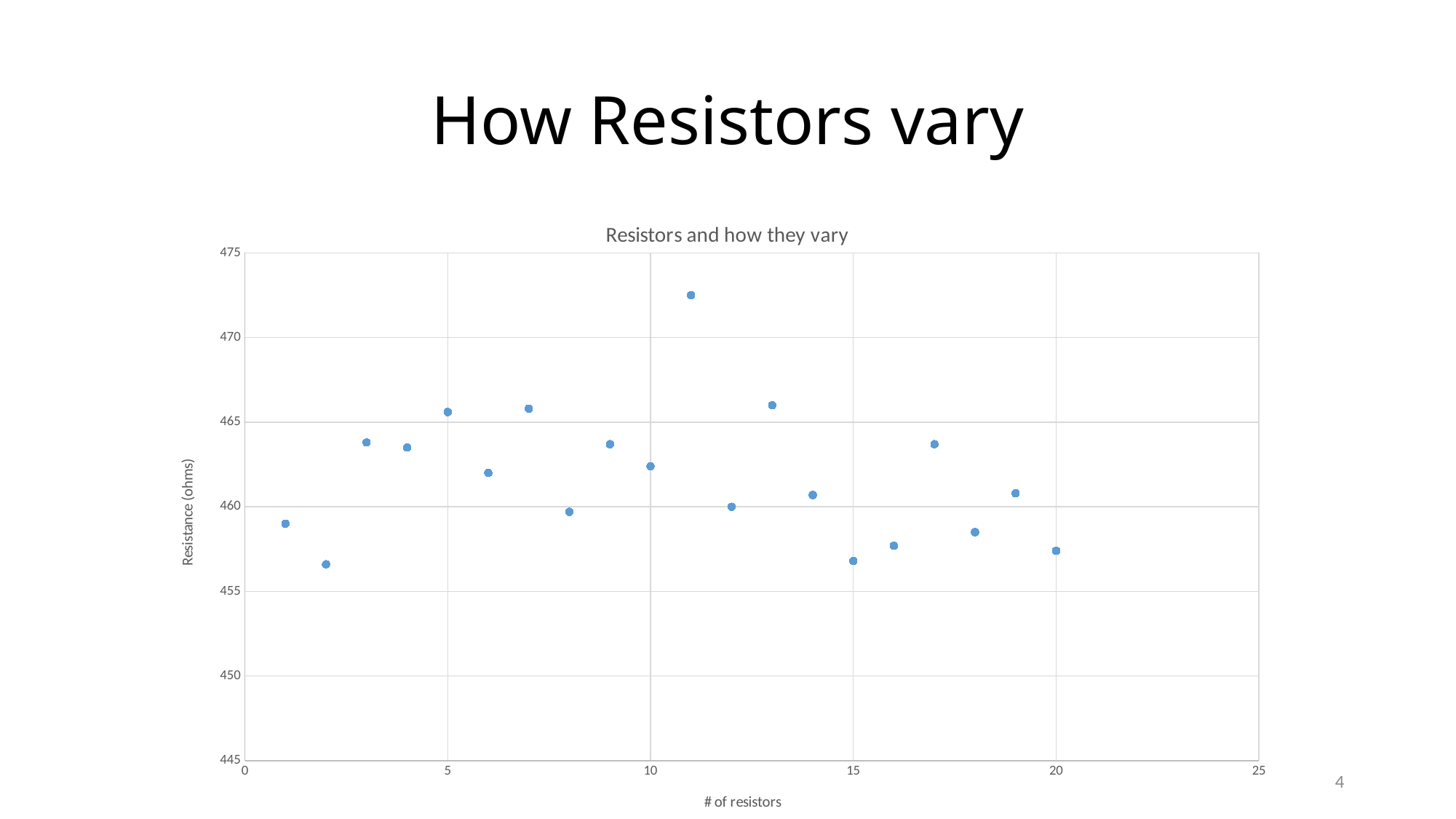
What is the label of the vertical axis? Resistance (ohms) Is the resistance for resistor 11 greater or less than 470? greater What kind of chart is shown on the slide? Scatter chart Is the resistance for resistor 15 greater or less than 460? less Which has the larger resistance, resistor 20 or resistor 17? Resistor 17 What is the title of the chart? Resistors and how they vary Is the resistance for resistor 13 greater or less than 465? greater Which resistor number has the highest resistance? 11 Which has the larger resistance, resistor 5 or resistor 8? Resistor 5 How many data points are plotted on the chart? 20